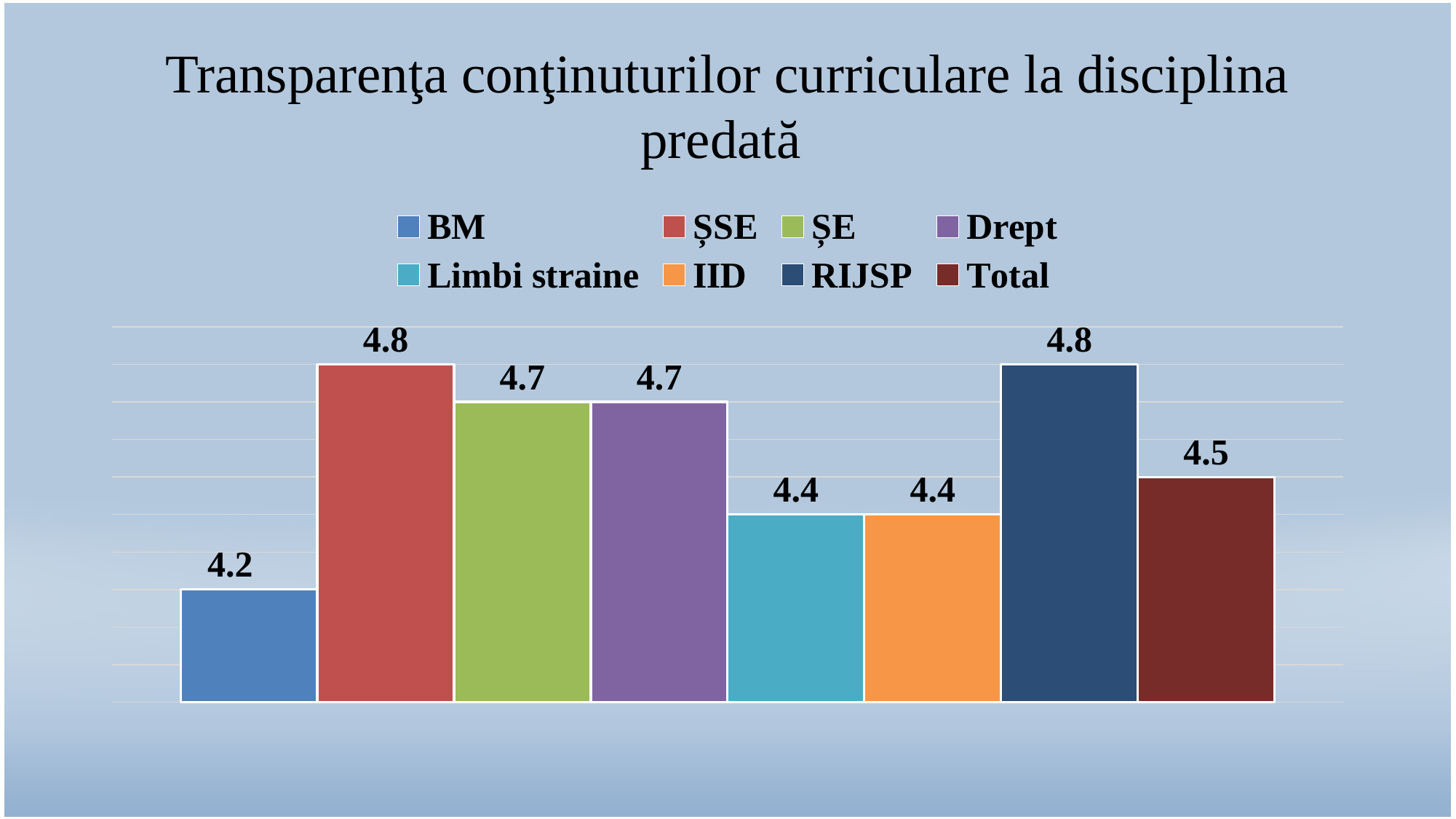
What kind of chart is shown on the slide? Bar chart Which category has the lowest value? BM Which is larger, the value for ȘE or the value for Limbi straine? ȘE What is the value for Total? 4.5 What is the value for Drept? 4.7 How many entries does the legend list? 8 What is the value for ȘSE? 4.8 What is the value for Limbi straine? 4.4 What is the difference between the values for RIJSP and BM? 0.6 How many bars are plotted in the chart? 8 What is the difference between the values for Total and IID? 0.1 What is the value for BM? 4.2